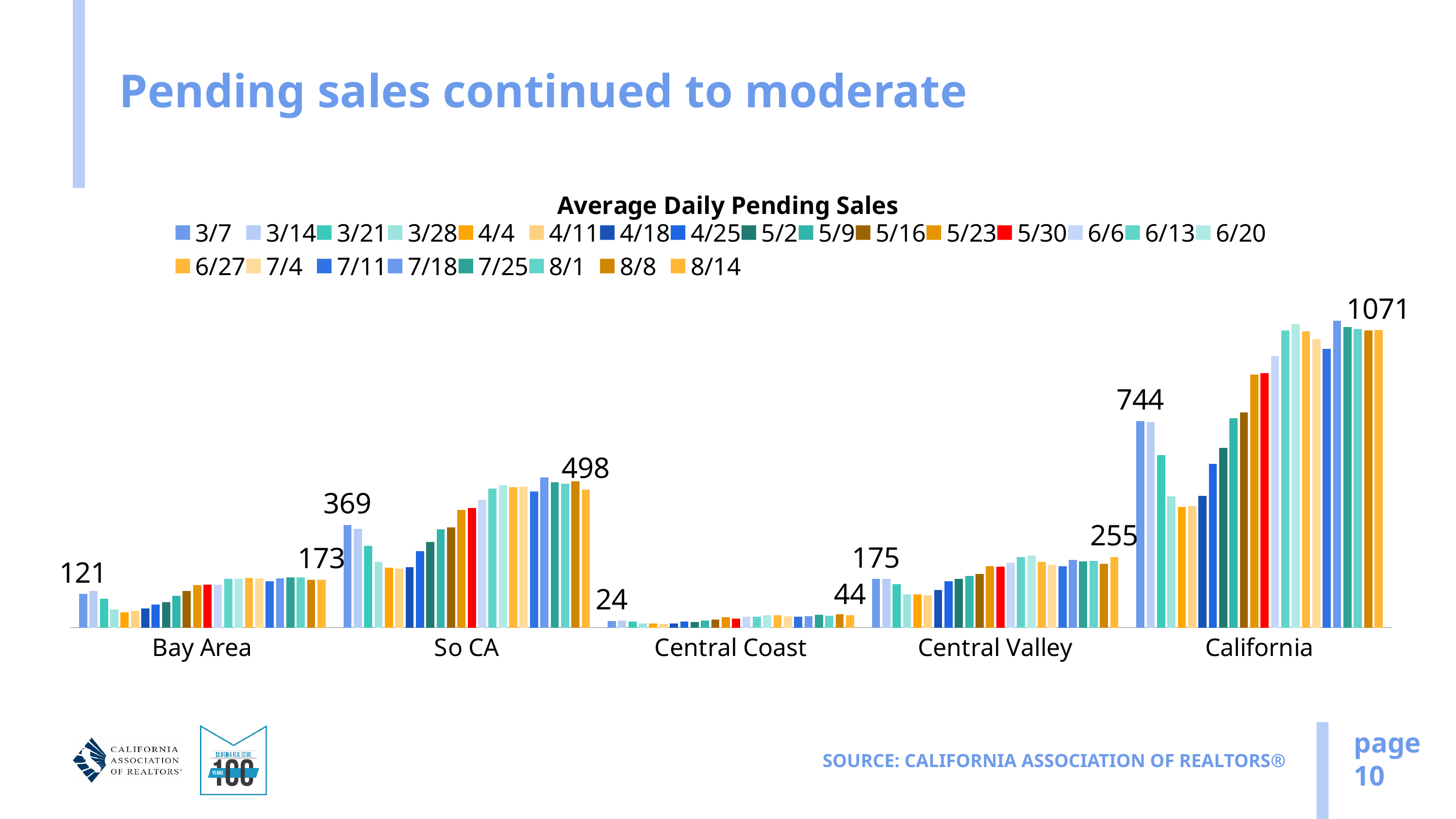
What is the difference between So CA's 8/14 value and its 3/7 value? 129 What is the value for So CA on 8/14? 498 How many series (dates) does the legend list? 24 Which region has the lowest average daily pending sales across the chart? Central Coast What kind of chart is shown on the slide? bar chart How many regions (categories) are shown on the x axis? 5 What is the average daily pending sales value for California on 3/7? 744 What is the value for Bay Area on 3/7? 121 By how much did California's average daily pending sales increase from 3/7 to 8/14? 327 What is the value for Central Valley on 3/7? 175 What is the average daily pending sales value for California on 8/14? 1071 What is the title of the chart? Average Daily Pending Sales